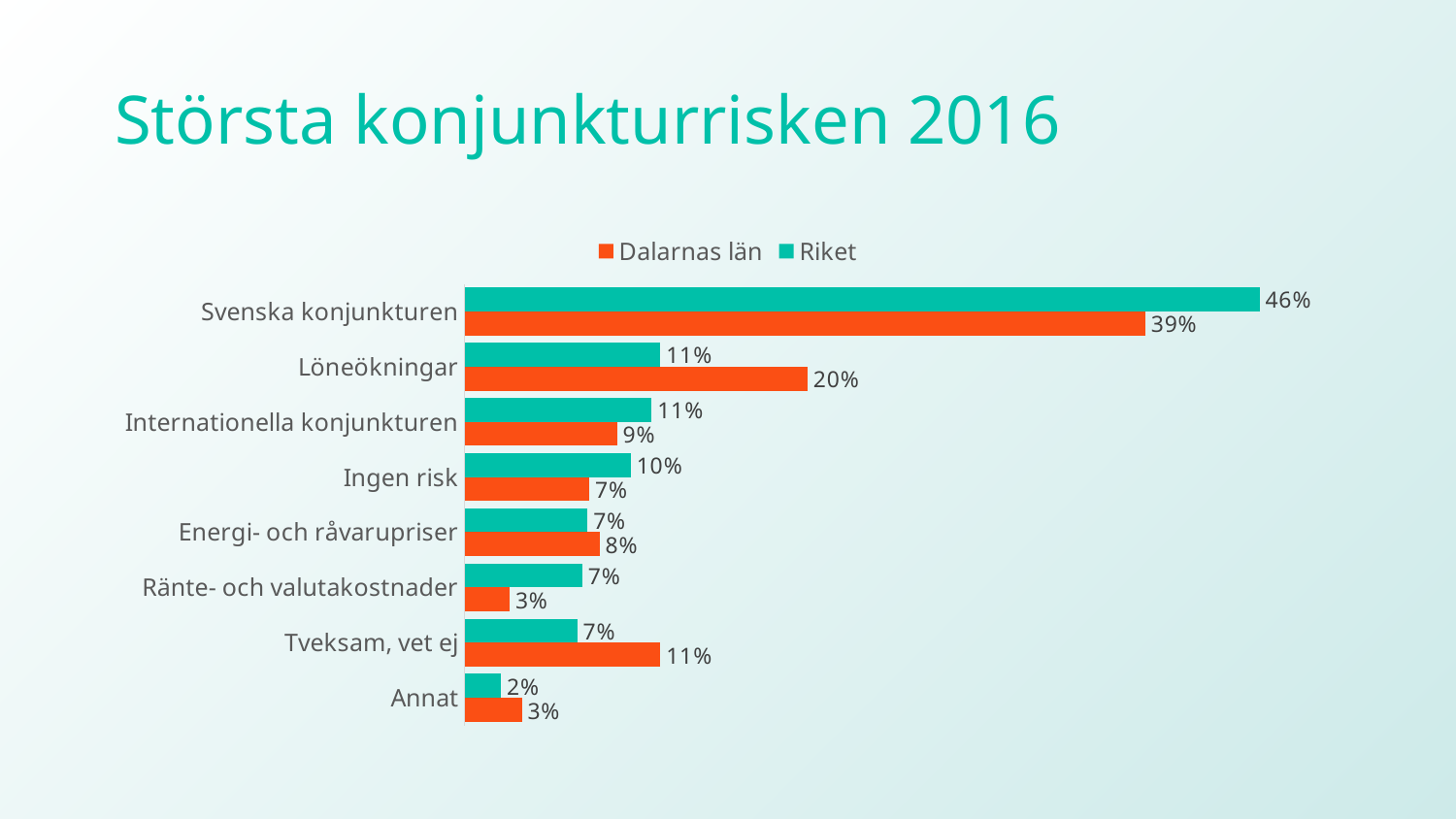
Which is larger for Tveksam, vet ej: Dalarnas län or Riket? Dalarnas län Which category has the highest value for Riket? Svenska konjunkturen Which is larger for Ingen risk: Dalarnas län or Riket? Riket What is the difference between Dalarnas län and Riket for Löneökningar? 9 percentage points What is the value for Dalarnas län for Ränte- och valutakostnader? 3% What kind of chart is shown on the slide? Bar chart Which category has the lowest value for Riket? Annat What is the value for Riket for Löneökningar? 11% How many categories are shown in the chart? 8 How many series does the legend list? 2 What is the value for Dalarnas län for Svenska konjunkturen? 39% What is the difference between Riket and Dalarnas län for Svenska konjunkturen? 7 percentage points